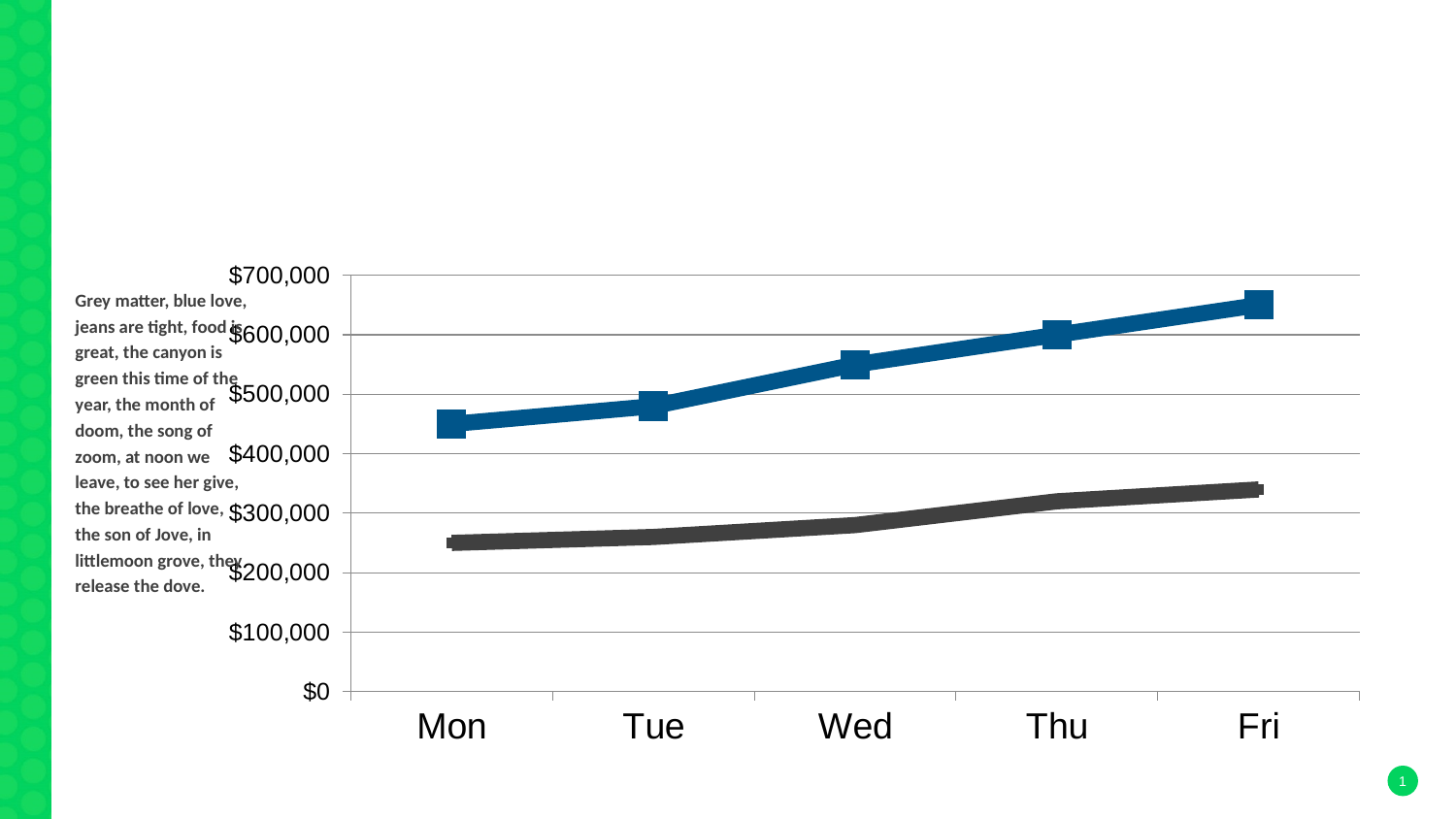
Is the value of the dark grey line for Mon greater or less than $200,000? greater Is the value of the dark grey line for Fri greater or less than $400,000? less How many categories are shown on the x axis of the chart? 5 What kind of chart is shown on the slide? line chart Is the value of the blue line for Wed greater or less than $500,000? greater On which day is the blue line at its lowest value? Mon Does the blue line rise or fall from Mon to Fri? rise On which day is the blue line at its highest value? Fri How many lines are plotted on the chart? 2 Does the dark grey line rise or fall from Mon to Fri? rise